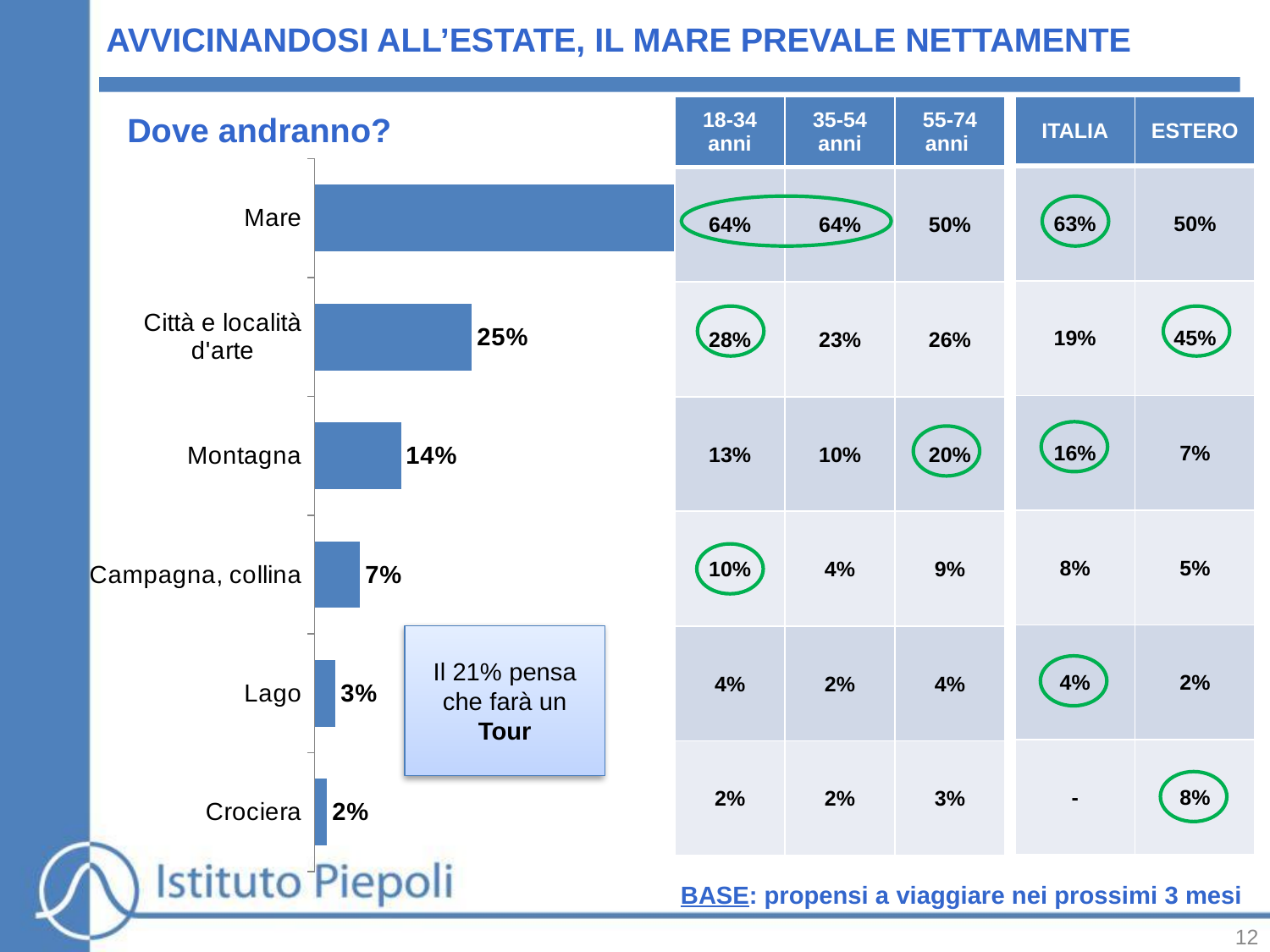
What is the value shown for "Montagna" in the bar chart? 14% Which category has the lowest value in the "Dove andranno?" chart? Crociera How many categories does the "Dove andranno?" bar chart show? 6 What is the difference between the values for "Città e località d'arte" and "Montagna" in the bar chart? 11 percentage points Which is larger in the bar chart, the value for "Campagna, collina" or the value for "Lago"? Campagna, collina What is the value shown for "Città e località d'arte" in the bar chart? 25% What is the title of the bar chart on the slide? Dove andranno? What is the value shown for "Crociera" in the bar chart? 2% What is the value shown for "Lago" in the bar chart? 3% Which category has the longest bar in the "Dove andranno?" chart? Mare What is the value shown for "Campagna, collina" in the bar chart? 7% What kind of chart is shown under the heading "Dove andranno?"? bar chart